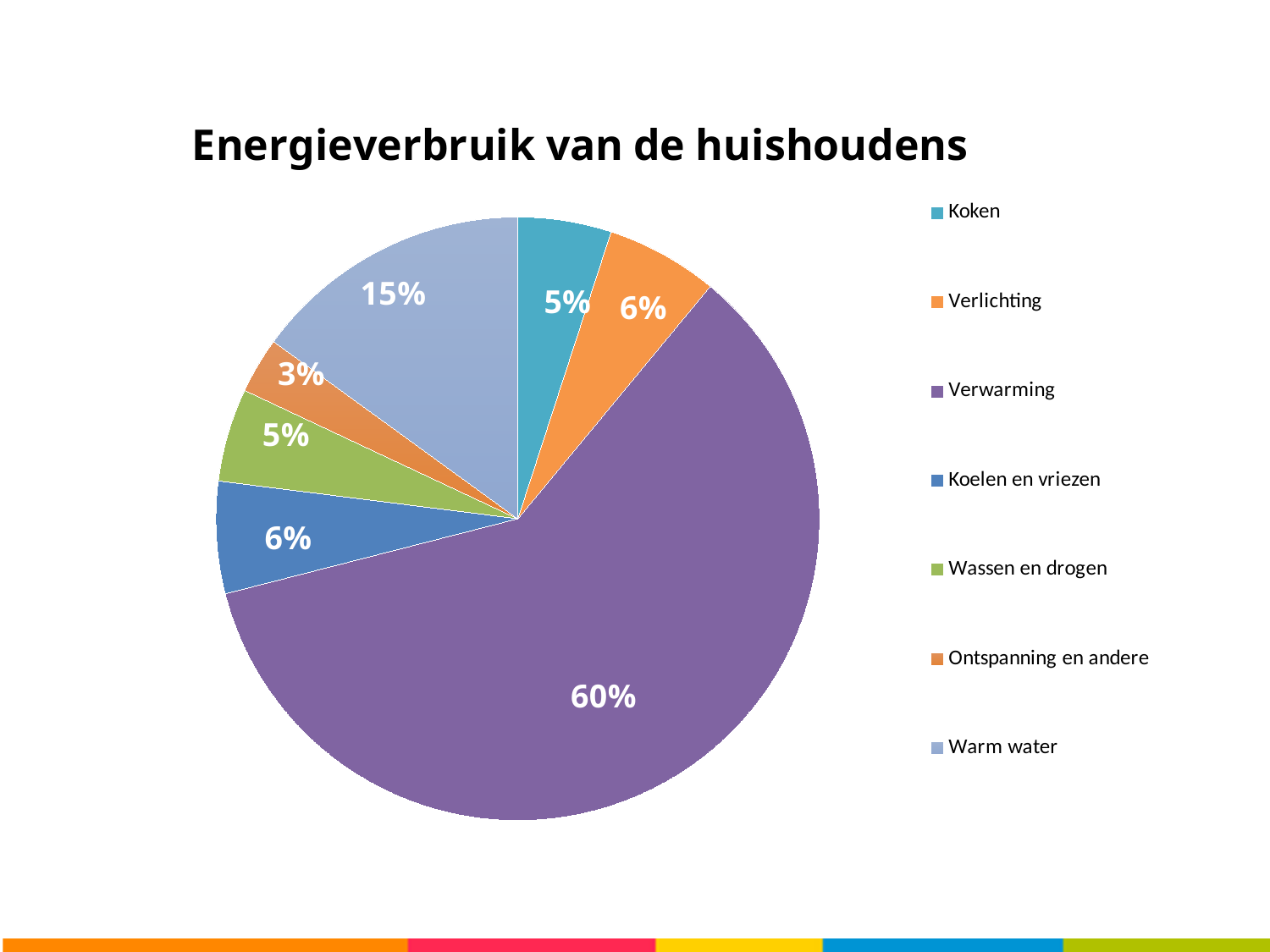
How many categories does the legend list? 7 Which is larger, the slice for Warm water or the slice for Verlichting? Warm water What is the title of the chart? Energieverbruik van de huishoudens What is the value shown for Ontspanning en andere? 3% What share of the pie does Verwarming take? 60% Which category has the largest slice of the pie? Verwarming What kind of chart is shown on the slide? pie chart What share of the pie does Warm water take? 15% What is the value shown for Koelen en vriezen? 6% What is the value shown for Koken? 5% Which category has the smallest slice of the pie? Ontspanning en andere What is the difference in percentage points between Verwarming and Warm water? 45